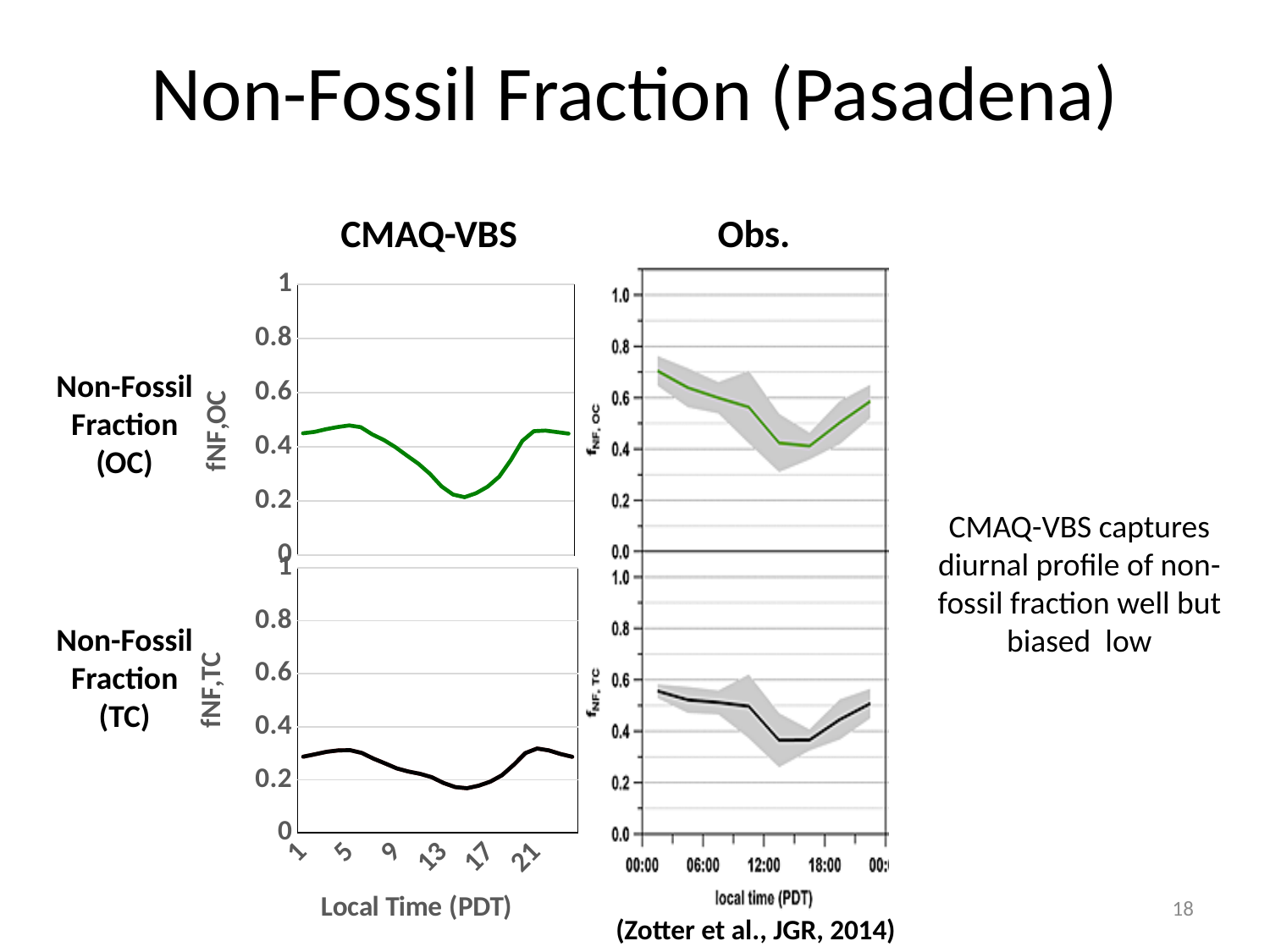
In the Obs. Non-Fossil Fraction (OC) chart, does the line rise or fall between 00:00 and 12:00? fall What is the x-axis label of the CMAQ-VBS charts? Local Time (PDT) In the CMAQ-VBS Non-Fossil Fraction (OC) chart, does the line rise or fall between local time 5 and local time 15? fall In the CMAQ-VBS Non-Fossil Fraction (TC) chart, is the lowest value of the line greater or less than 0.2? less What kind of chart is the CMAQ-VBS Non-Fossil Fraction (OC) chart? line chart What colour is the line in the CMAQ-VBS Non-Fossil Fraction (OC) chart? green In the CMAQ-VBS Non-Fossil Fraction (OC) chart, is the lowest value of the line greater or less than 0.4? less In the Obs. Non-Fossil Fraction (TC) chart, is the value at 00:00 greater or less than 0.4? greater In the CMAQ-VBS Non-Fossil Fraction (TC) chart, is the value at local time 1 larger or smaller than the value at local time 15? larger